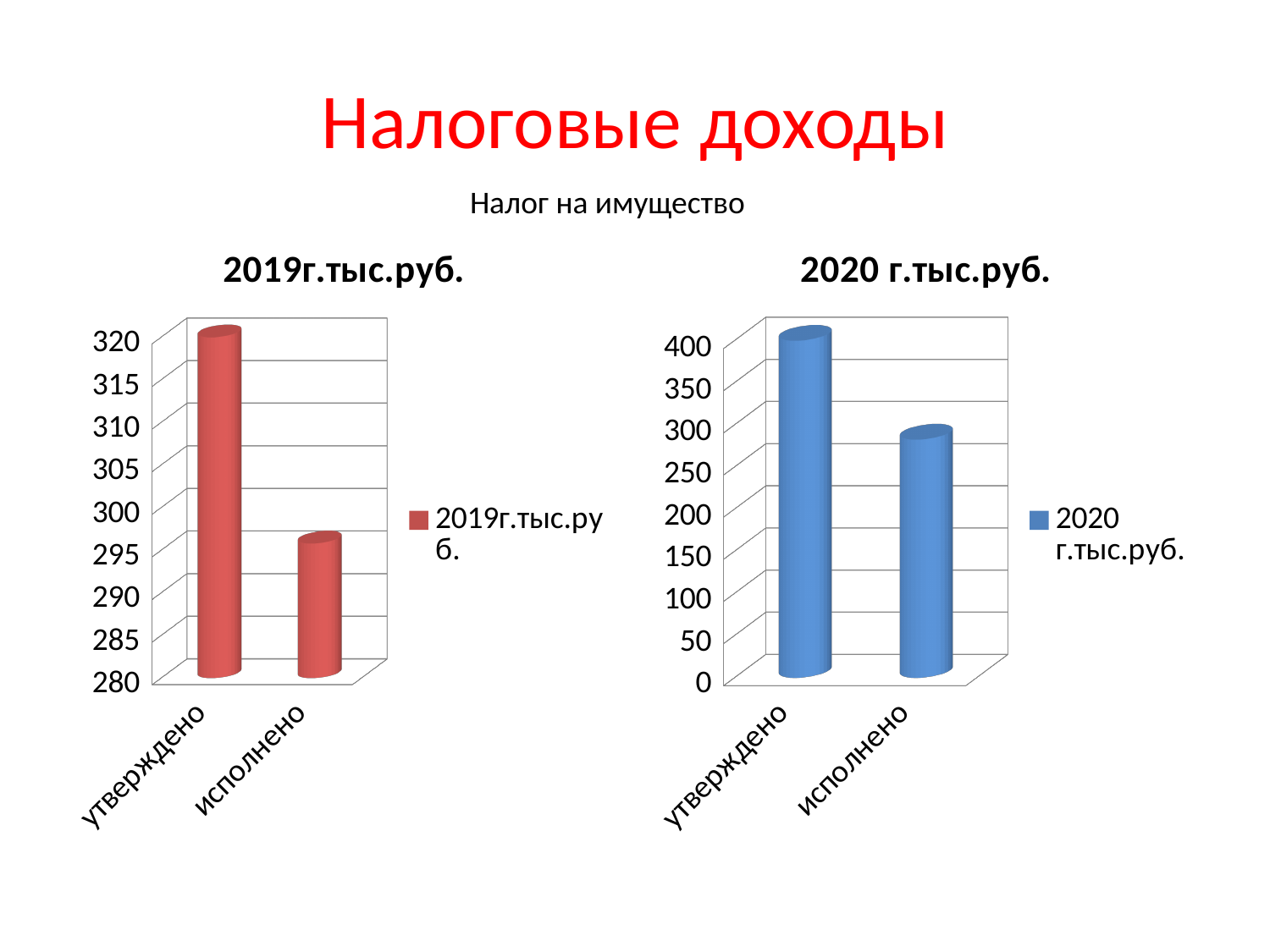
How many series does the legend of the chart titled "2020 г.тыс.руб." list? 1 In the chart titled "2020 г.тыс.руб.", which category has the highest value? утверждено In the chart titled "2020 г.тыс.руб.", is the value for утверждено greater or less than 350? greater In the chart titled "2019г.тыс.руб.", is the value for исполнено greater or less than 300? less How many categories are shown in the chart titled "2019г.тыс.руб."? 2 What colour are the bars in the chart titled "2019г.тыс.руб."? red In the chart titled "2019г.тыс.руб.", which category has the lowest value? исполнено In the chart titled "2020 г.тыс.руб.", which is larger, утверждено or исполнено? утверждено What kind of chart is the chart titled "2020 г.тыс.руб."? bar chart In the chart titled "2019г.тыс.руб.", which category has the highest value? утверждено In the chart titled "2019г.тыс.руб.", is the value for утверждено greater or less than 310? greater